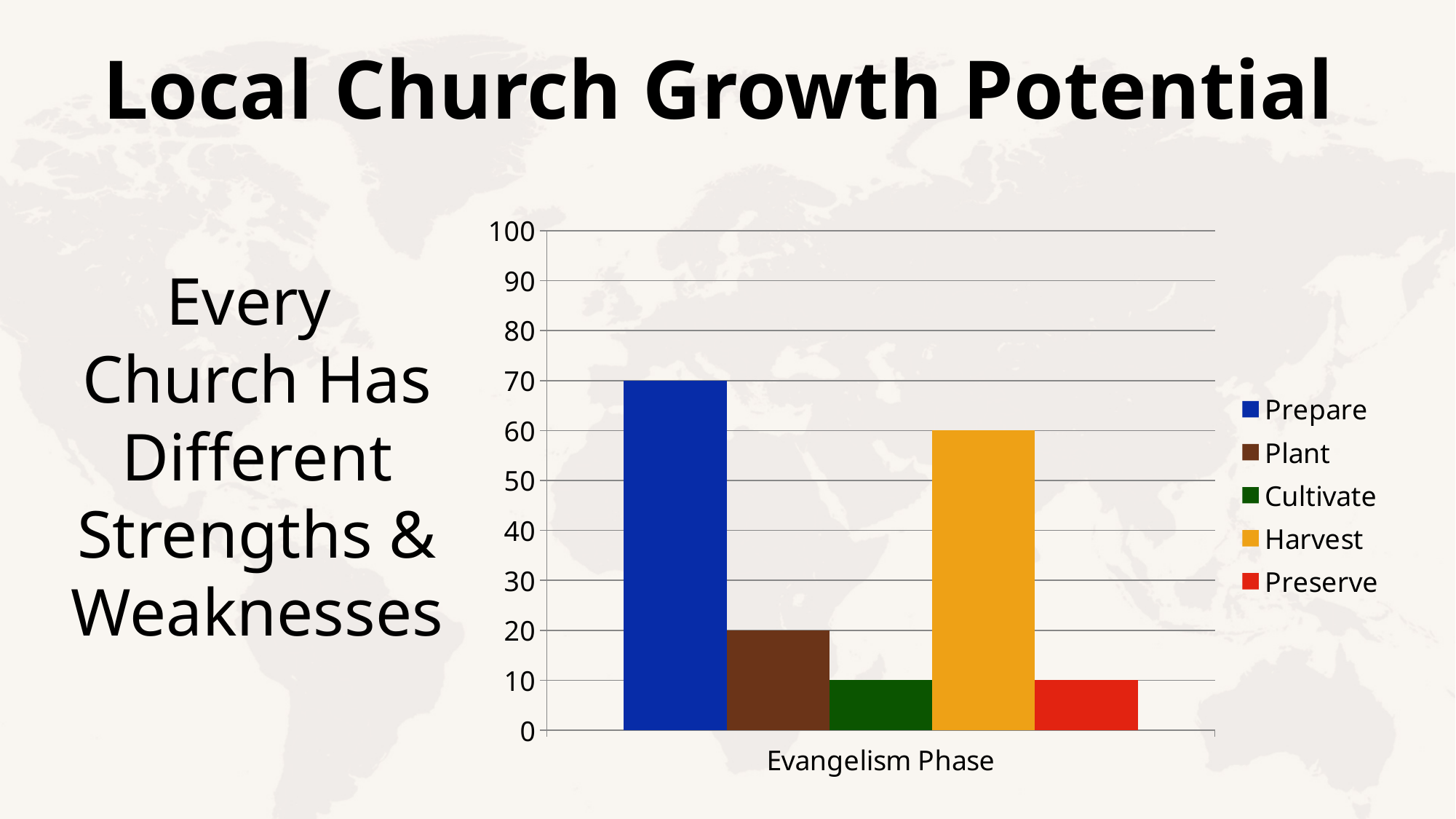
What is the value for Cultivate in the chart? 10 What is the value for Harvest in the chart? 60 What is the value for Prepare in the chart? 70 What is the difference between the values for Prepare and Harvest? 10 What is the difference between the values for Harvest and Plant? 40 What is the label on the x axis of the chart? Evangelism Phase Which series has the highest value in the chart? Prepare What is the value for Plant in the chart? 20 Is the value for Harvest greater or less than 50? greater Which is larger, the value for Plant or the value for Preserve? Plant What kind of chart is shown on the slide? bar chart How many series does the legend list? 5